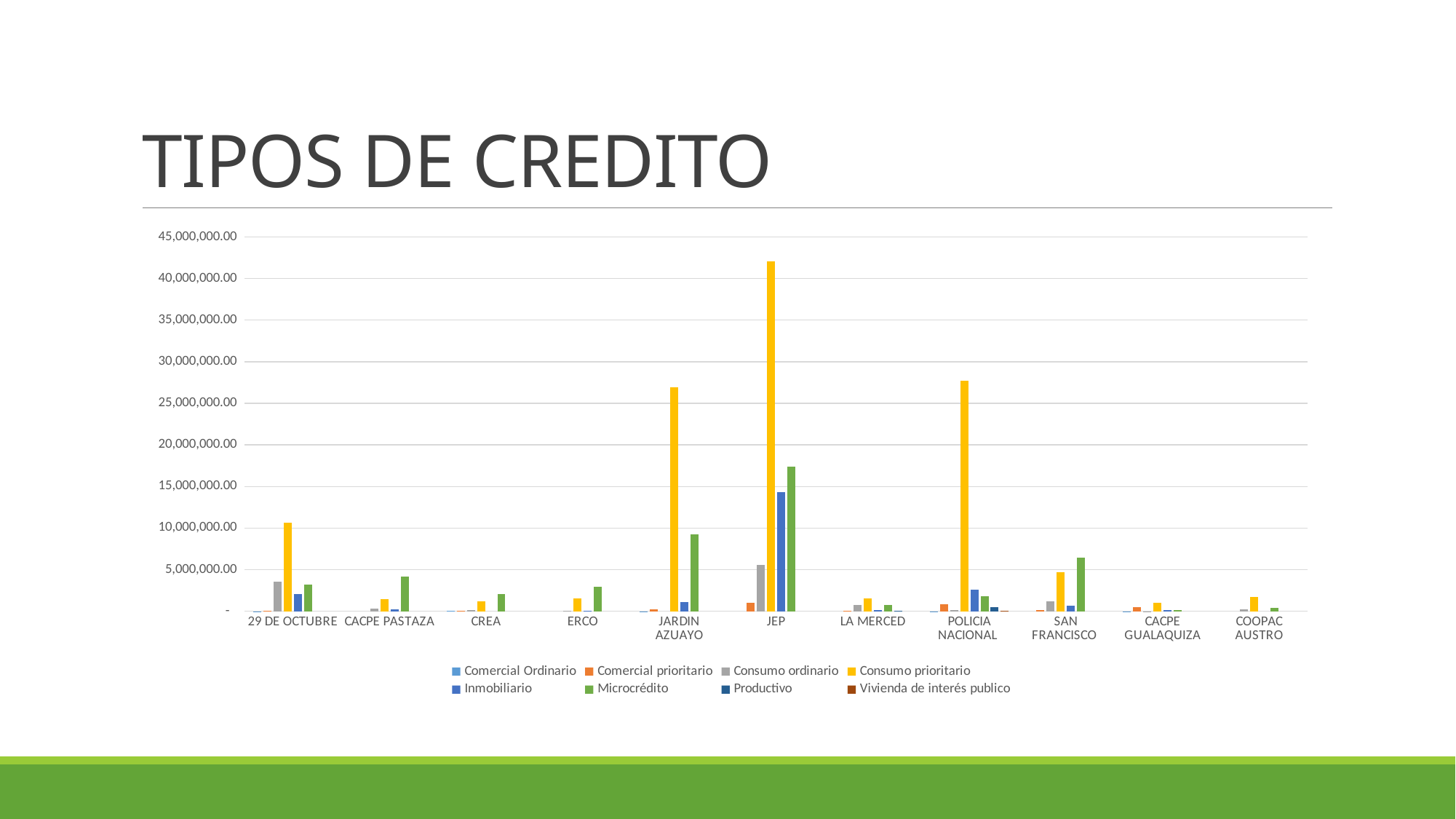
Is the Consumo prioritario value for JARDIN AZUAYO greater or less than 25,000,000.00? greater Is the Inmobiliario value for JEP greater or less than 10,000,000.00? greater Which cooperative has the highest Microcrédito bar? JEP Is the Consumo prioritario value for JEP greater or less than 40,000,000.00? greater What is the title of the slide containing the chart? TIPOS DE CREDITO How many cooperatives (categories) are shown on the x axis? 11 Which cooperative has the highest Consumo prioritario bar? JEP What kind of chart is shown on the slide? bar chart Which is larger, the Consumo prioritario value for 29 DE OCTUBRE or for SAN FRANCISCO? 29 DE OCTUBRE How many series does the legend list? 8 Which is larger, the Microcrédito value for JEP or for JARDIN AZUAYO? JEP